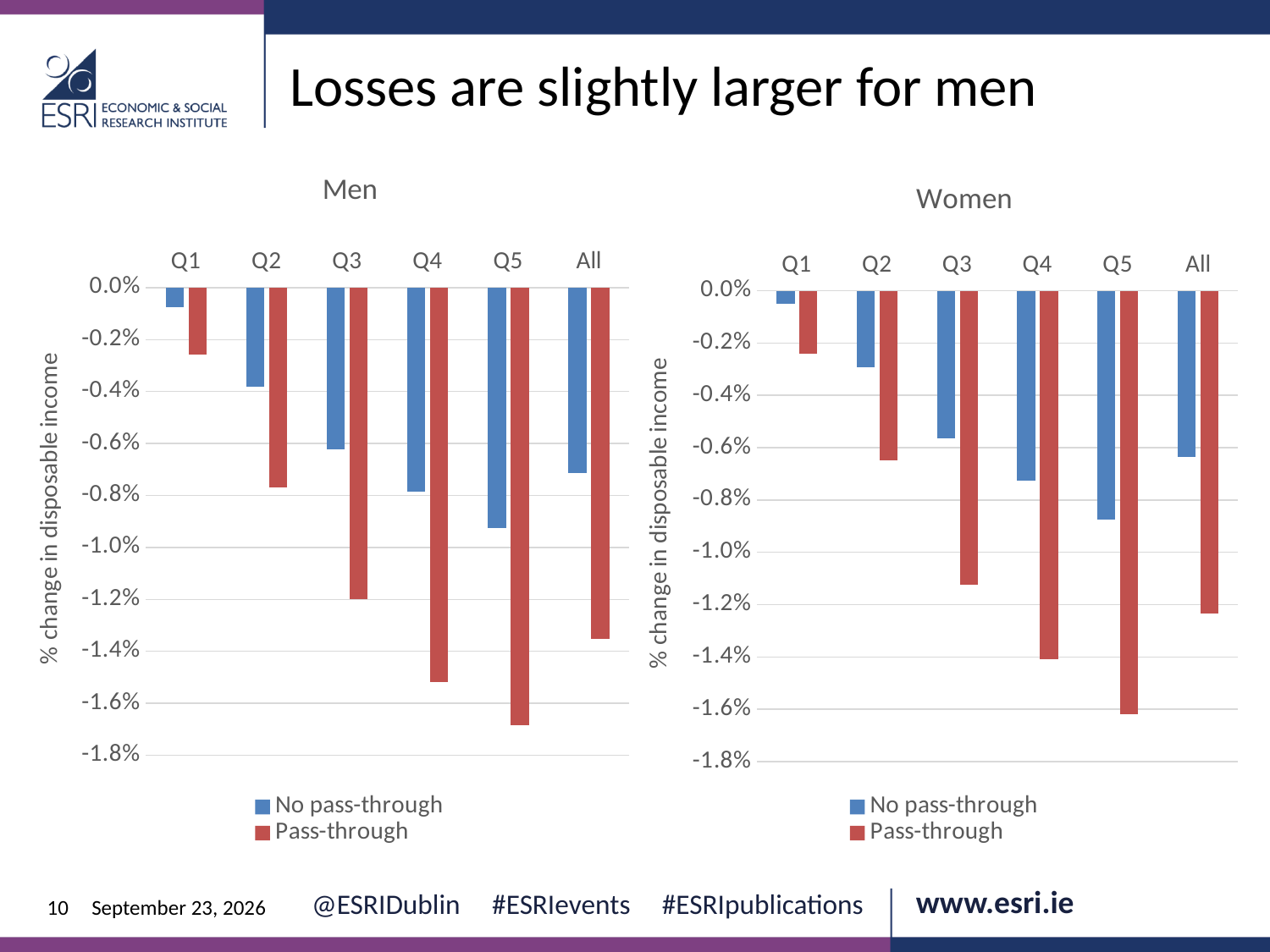
In the Women chart, which colour represents the Pass-through series? red In the Men chart, is the Pass-through value for Q5 greater or less than -1.6%? less In the Women chart, is the No pass-through value for Q2 greater or less than -0.4%? greater In the Men chart, which is larger for Q3: the No pass-through value or the Pass-through value? No pass-through In the Women chart, is the Pass-through value for Q4 greater or less than -1.2%? less How many categories are shown on the x axis of the Men chart? 6 In the Women chart, which category has the highest (closest to zero) No pass-through value? Q1 What is the y-axis title of the Men chart? % change in disposable income How many series does the legend of the Women chart list? 2 What kind of chart is the Men chart? bar chart In the Men chart, which category has the lowest (most negative) Pass-through value? Q5 In the Women chart, do the Pass-through values rise or fall from Q1 to Q5? fall